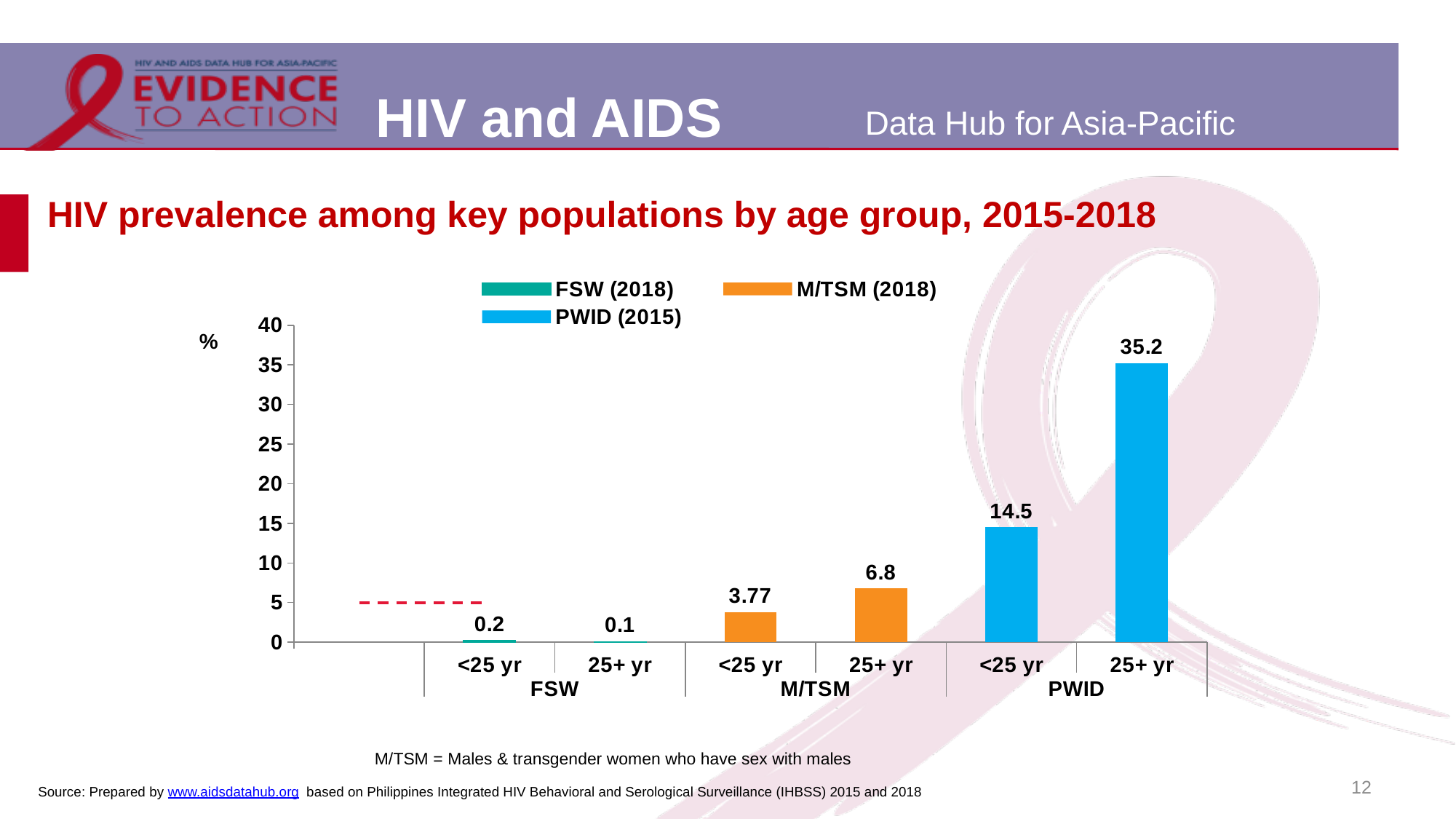
Is the HIV prevalence for PWID aged 25+ yr greater or less than 30? greater What is the difference in HIV prevalence between PWID aged 25+ yr and PWID aged <25 yr? 20.7 Which group and age category has the highest HIV prevalence? PWID 25+ yr What is the HIV prevalence among FSW aged 25+ yr? 0.1 What is the difference in HIV prevalence between M/TSM aged 25+ yr and M/TSM aged <25 yr? 3.03 Which group and age category has the lowest HIV prevalence? FSW 25+ yr How many series does the legend list? 3 What kind of chart is shown on the slide? Bar chart What is the HIV prevalence among M/TSM aged <25 yr? 3.77 What is the HIV prevalence among PWID aged 25+ yr? 35.2 What is the HIV prevalence among PWID aged <25 yr? 14.5 Which has a higher HIV prevalence: M/TSM aged 25+ yr or PWID aged <25 yr? PWID aged <25 yr